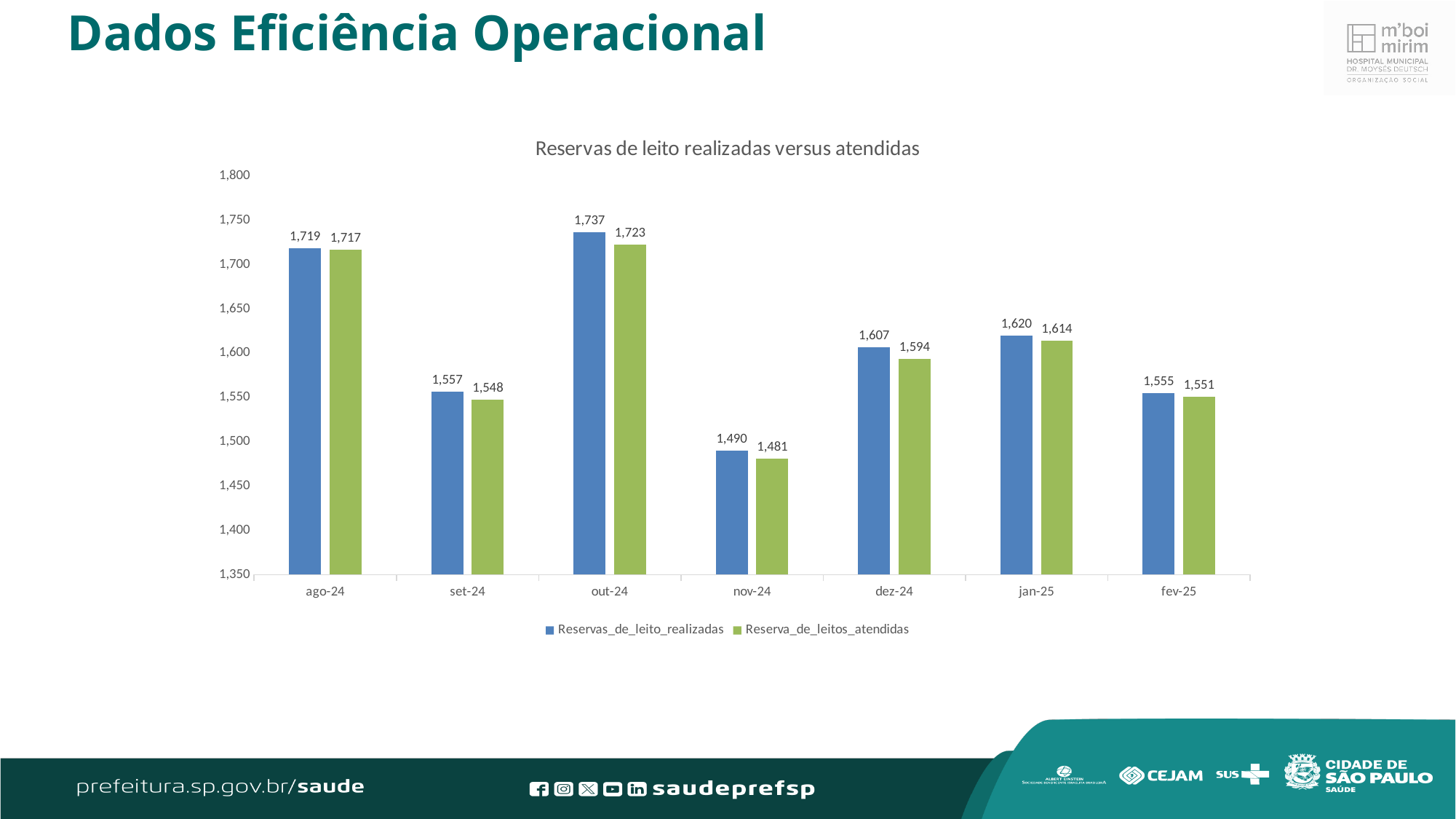
What kind of chart is shown? bar chart What is the value of Reservas_de_leito_realizadas for out-24? 1,737 Which month has the lowest value for Reserva_de_leitos_atendidas? nov-24 What is the value of Reservas_de_leito_realizadas for fev-25? 1,555 Which is larger: Reservas_de_leito_realizadas in jan-25 or in set-24? jan-25 What is the title of the chart? Reservas de leito realizadas versus atendidas Is the value of Reserva_de_leitos_atendidas for ago-24 greater or less than 1,700? greater Which month has the highest value for Reservas_de_leito_realizadas? out-24 How many months are shown on the x axis? 7 How many series does the legend list? 2 What is the value of Reserva_de_leitos_atendidas for nov-24? 1,481 What is the difference between Reservas_de_leito_realizadas and Reserva_de_leitos_atendidas in dez-24? 13